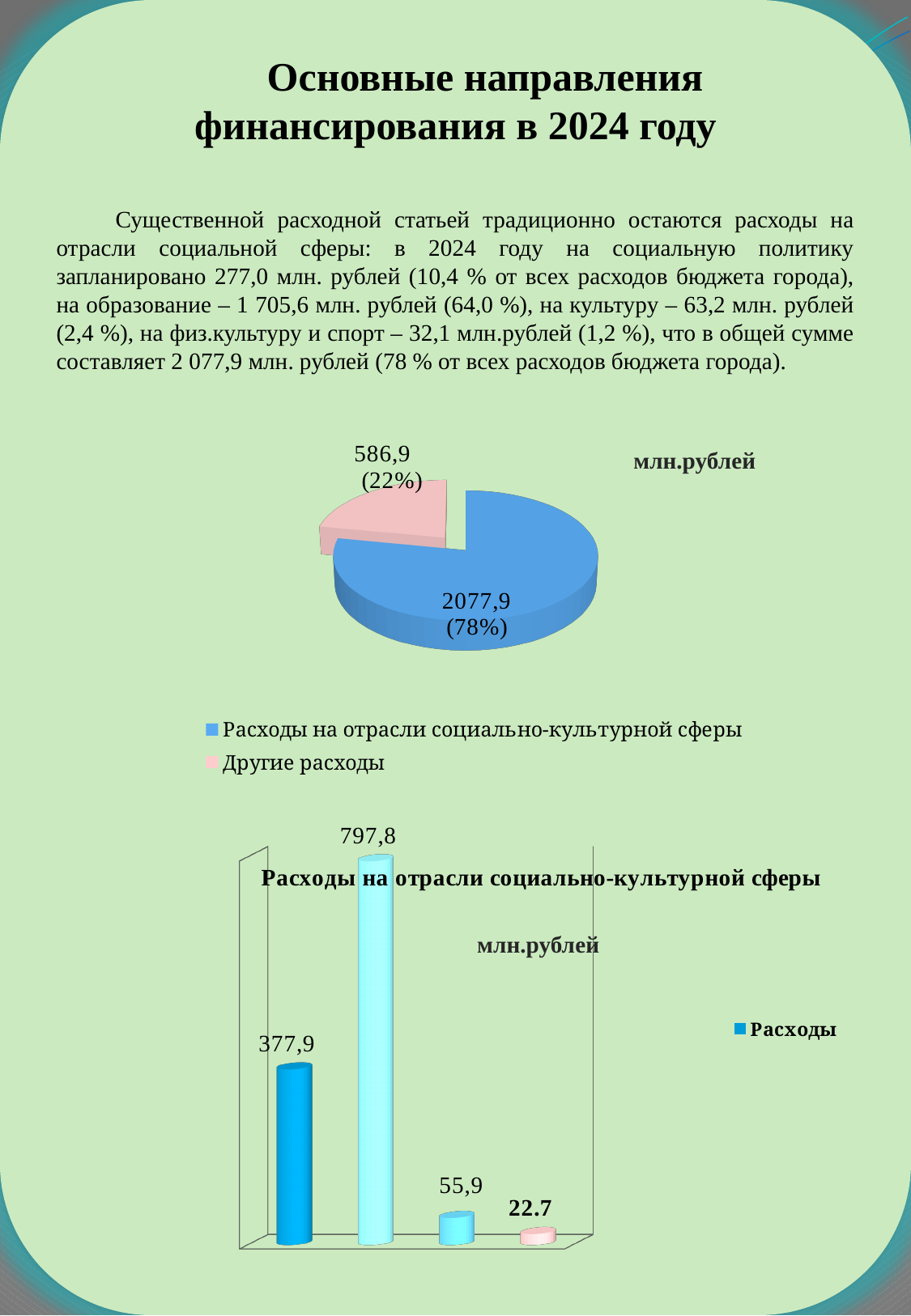
On the bottom bar chart, how many bars are plotted? 4 On the pie chart, what share of the pie does Расходы на отрасли социально-культурной сферы take? 78% On the pie chart, what share of the pie does Другие расходы take? 22% What kind of chart is the bottom chart titled Расходы на отрасли социально-культурной сферы? bar chart On the bottom bar chart, what is the value of the tallest bar? 797,8 On the pie chart, what value is shown for Другие расходы? 586,9 On the bottom bar chart, what is the value of the smallest bar? 22.7 On the pie chart, how many entries does the legend list? 2 On the pie chart, what unit is indicated next to the chart? млн.рублей On the pie chart, what value is shown for Расходы на отрасли социально-культурной сферы? 2077,9 On the pie chart, which slice is larger: Расходы на отрасли социально-культурной сферы or Другие расходы? Расходы на отрасли социально-культурной сферы On the bottom bar chart, what is the difference between the second bar (797,8) and the first bar (377,9)? 419,9